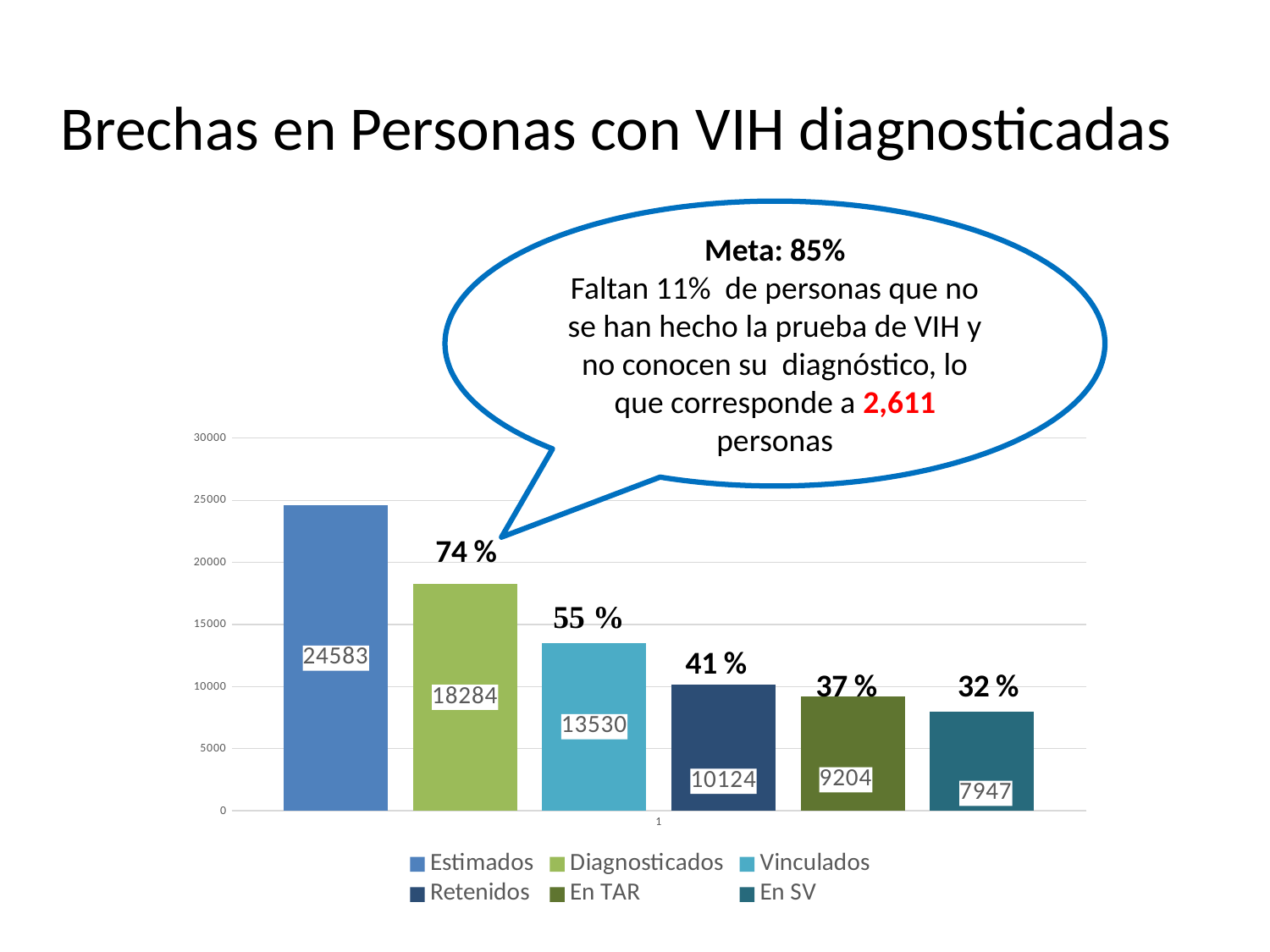
Which series has the lowest value? En SV What is the value for En SV? 7947 What is the difference between the Retenidos and En TAR values? 920 How many series does the legend list? 6 What is the value for Diagnosticados? 18284 Which is larger, Vinculados or Retenidos? Vinculados What percentage is shown above the Vinculados bar? 55 % Which series has the highest value? Estimados What kind of chart is shown? bar chart Do the bar values rise or fall from left to right? fall What is the difference between the Estimados and Diagnosticados values? 6299 What is the value for Estimados? 24583